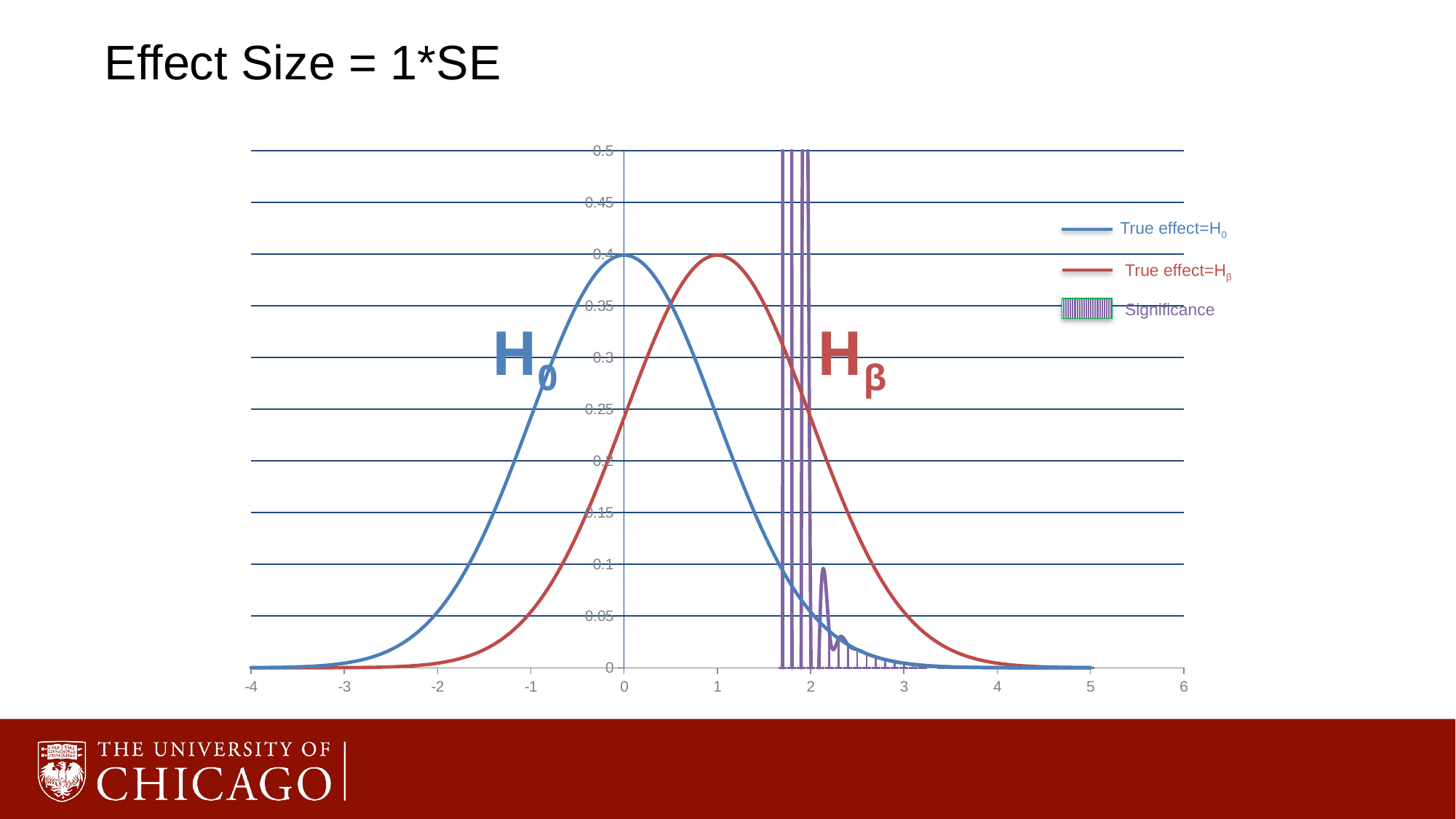
At x = -1, which curve is higher, the blue 'True effect=H0' curve or the red 'True effect=Hβ' curve? True effect=H0 Is the value of the red 'True effect=Hβ' curve at x = 2 greater or less than 0.2? greater What is the title of the slide containing the chart? Effect Size = 1*SE Is the value of the blue 'True effect=H0' curve at x = 1 greater or less than 0.3? less Does the blue 'True effect=H0' curve rise or fall as x goes from 0 to 4? fall At which x value does the red 'True effect=Hβ' curve reach its peak? 1 How many entries does the chart legend list? 3 At which x value does the blue 'True effect=H0' curve reach its peak? 0 What kind of chart is shown on the slide? line chart Is the value of the blue 'True effect=H0' curve at x = 2 greater or less than 0.1? less At x = 2, which curve is higher, the blue 'True effect=H0' curve or the red 'True effect=Hβ' curve? True effect=Hβ